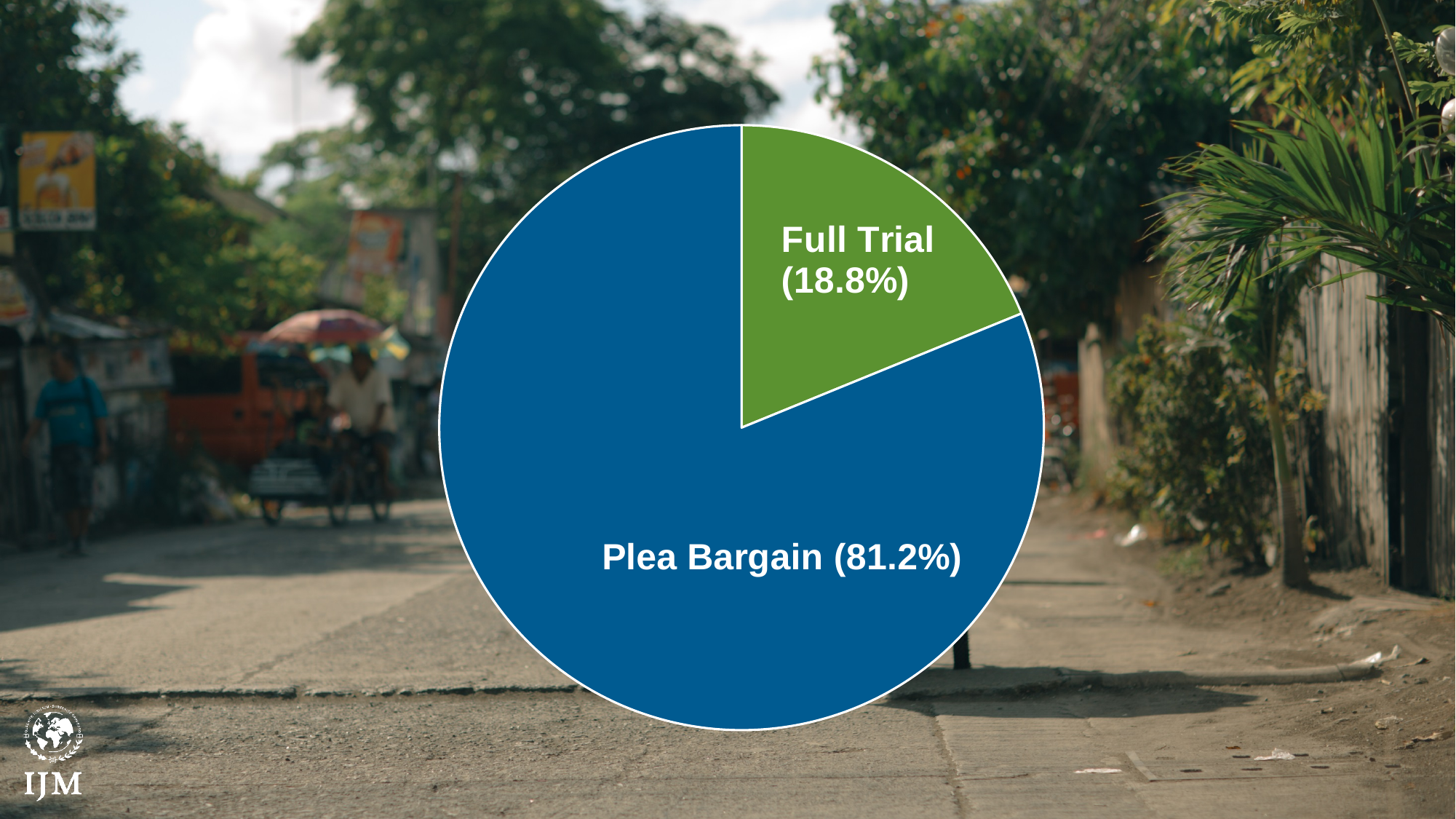
What colour is the Full Trial slice? green What share of the pie does Full Trial represent? 18.8% How many slices does the pie chart have? 2 What kind of chart is shown on the slide? pie chart Which slice of the pie is the smallest? Full Trial Which slice of the pie is the largest? Plea Bargain What share of the pie does Plea Bargain represent? 81.2% What colour is the Plea Bargain slice? blue What is the difference in percentage points between Plea Bargain and Full Trial? 62.4 Which is larger, the Full Trial slice or the Plea Bargain slice? Plea Bargain